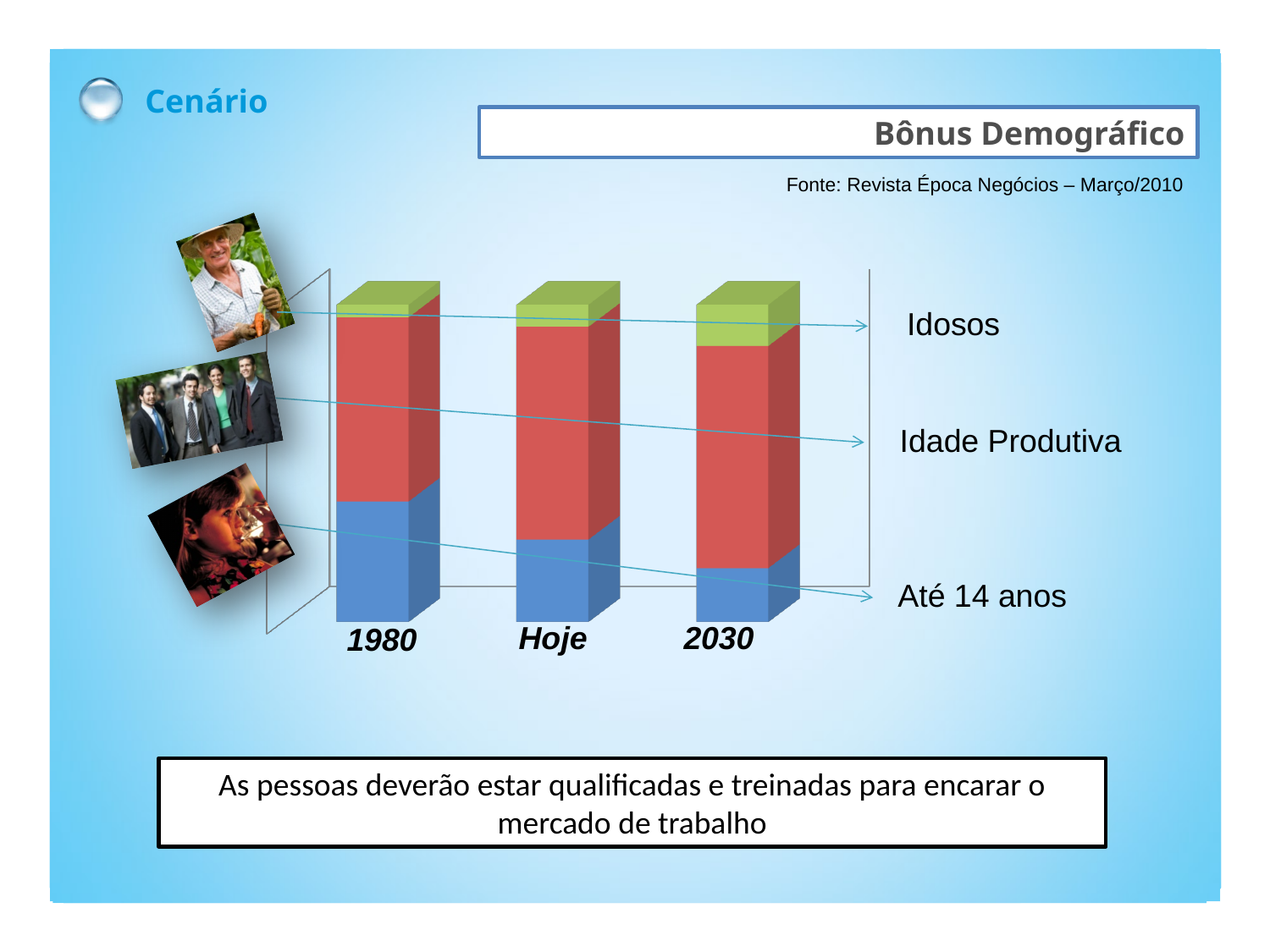
How many bars (time periods) does the chart show? 3 How many series (age groups) are shown in the stacked bars? 3 What are the three categories labelled along the bottom of the chart? 1980, Hoje, 2030 In which bar is the 'Até 14 anos' segment the largest? 1980 Which age group forms the largest segment in every bar? Idade Produtiva Does the 'Até 14 anos' segment rise or fall from 1980 to 2030? Fall What is the title shown in the box above the chart? Bônus Demográfico Does the 'Idosos' segment rise or fall from 1980 to 2030? Rise In which bar is the 'Idosos' segment the largest? 2030 Which age group is the smallest segment in the 1980 bar? Idosos In which bar is the 'Até 14 anos' segment the smallest? 2030 What kind of chart is shown on the slide? Stacked bar chart